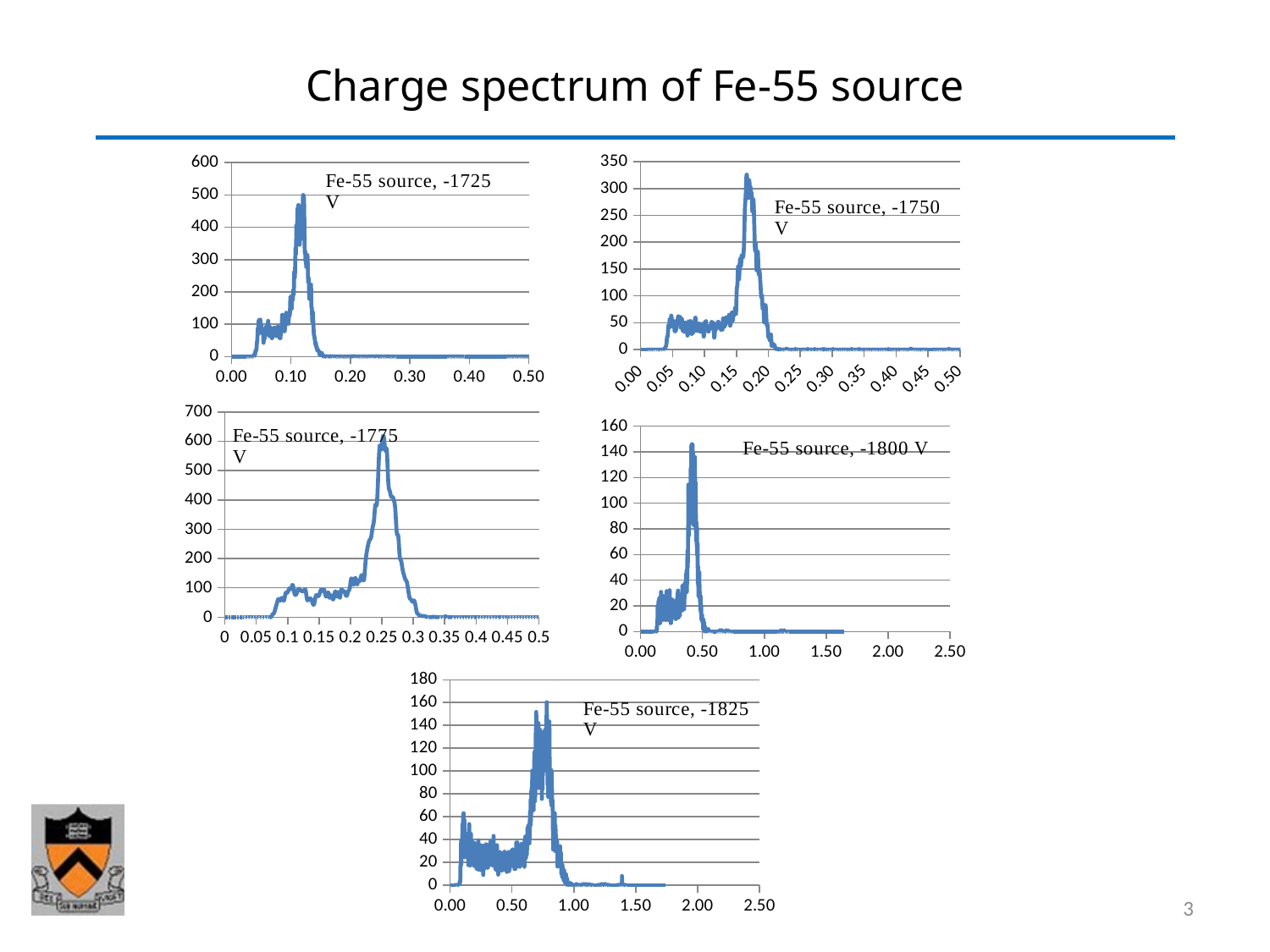
What kind of chart is the 'Fe-55 source, -1725 V' chart? line chart In the 'Fe-55 source, -1825 V' chart, is the peak value greater or less than 140? greater In the 'Fe-55 source, -1725 V' chart, is the x position of the main peak greater or less than 0.20? less In the 'Fe-55 source, -1775 V' chart, is the peak value greater or less than 500? greater Which chart reaches a higher peak, 'Fe-55 source, -1725 V' or 'Fe-55 source, -1775 V'? Fe-55 source, -1775 V In the 'Fe-55 source, -1775 V' chart, do the values rise or fall between x = 0.25 and x = 0.35? fall How many charts are shown on the slide? 5 What is the highest tick on the horizontal axis of the 'Fe-55 source, -1800 V' chart? 2.50 What is the highest tick on the vertical axis of the 'Fe-55 source, -1775 V' chart? 700